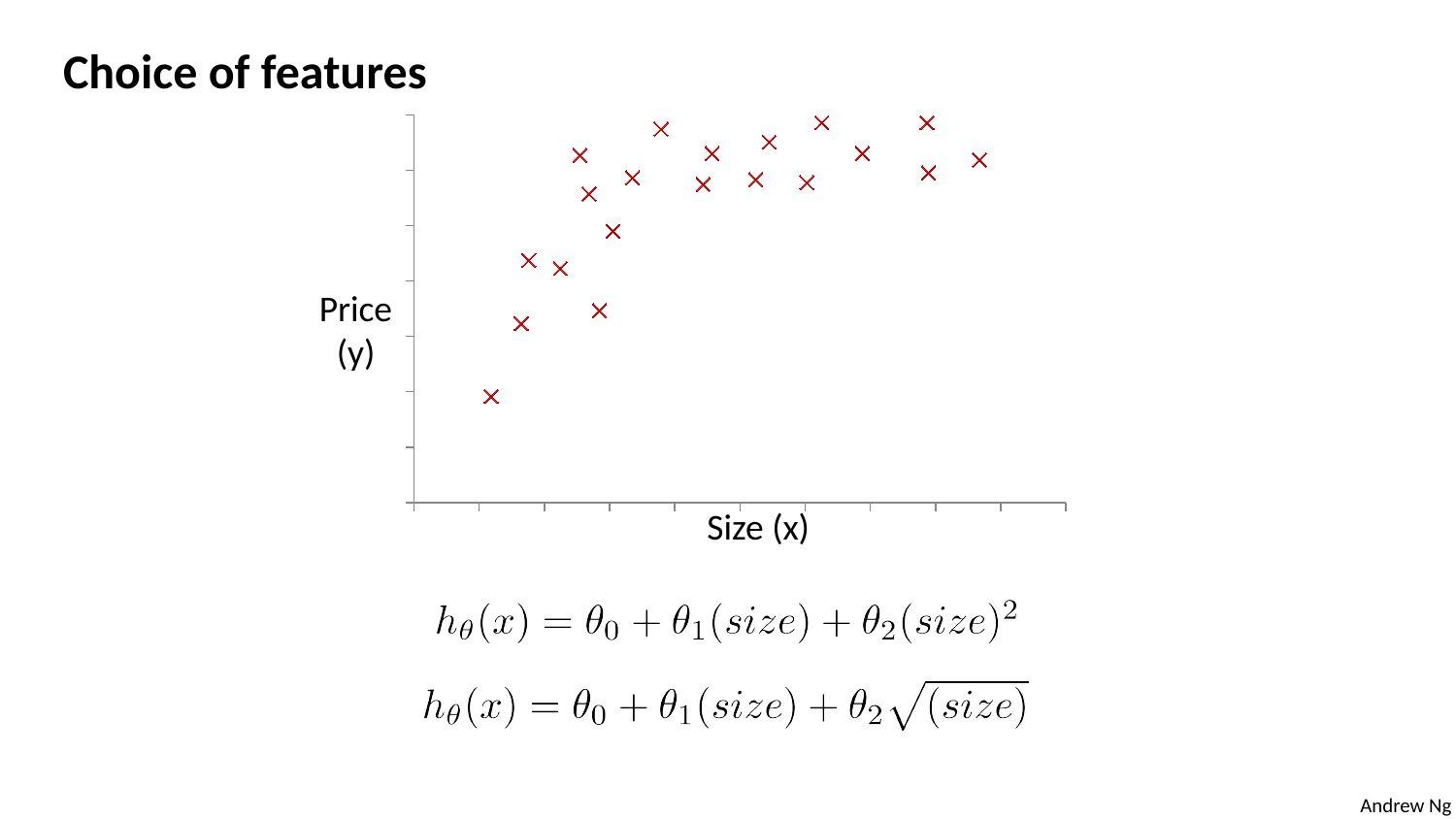
What kind of chart is shown on the slide? scatter plot What is the label of the vertical axis of the chart? Price (y) Do the plotted Price values generally rise or fall as Size increases along the x axis? rise How many data points are plotted on the chart? 20 What is the label of the horizontal axis of the chart? Size (x)